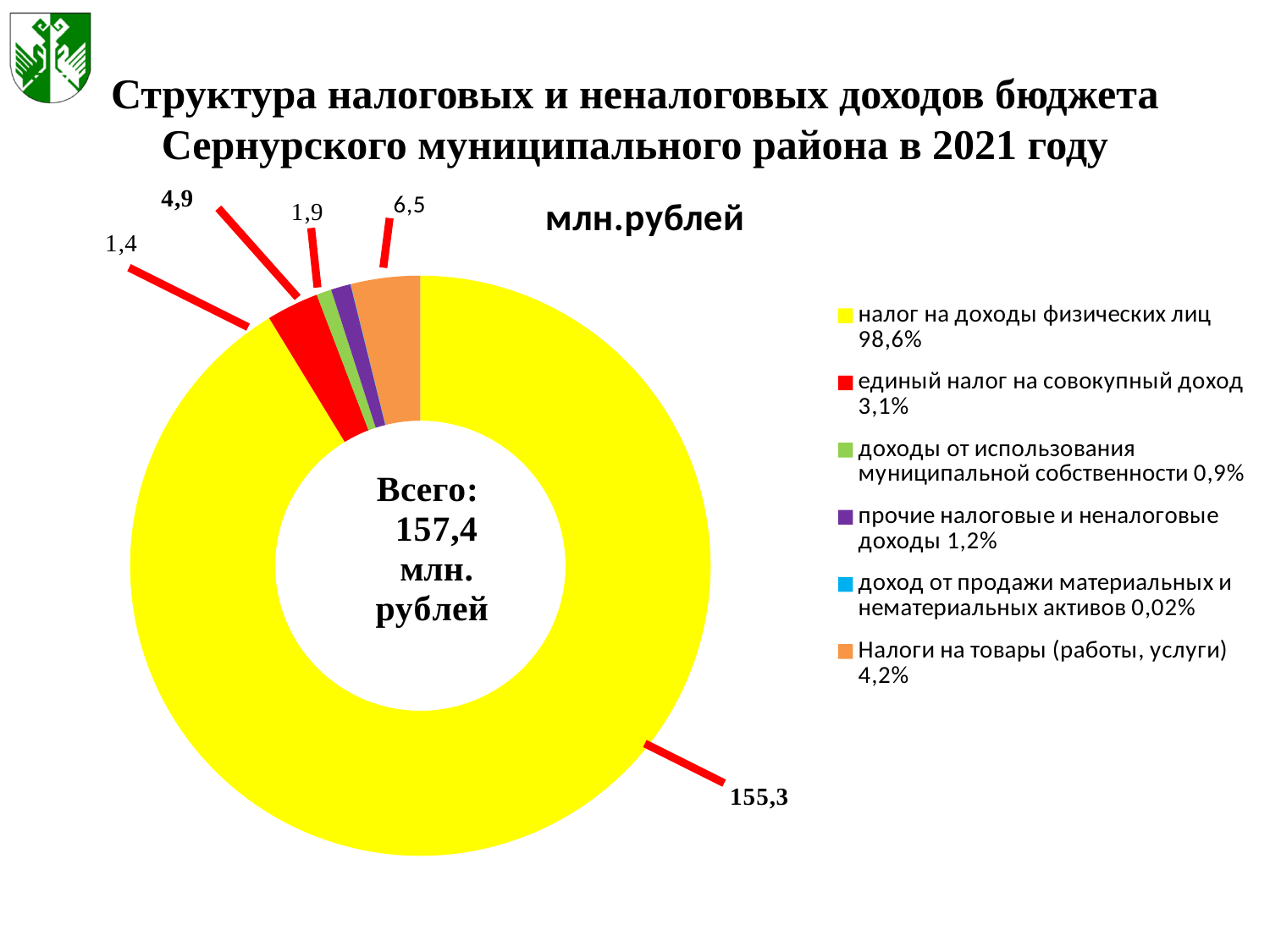
What kind of chart is shown on the slide? Doughnut (pie) chart What share of the chart does Налоги на товары (работы, услуги) represent? 4,2% What is the value for налог на доходы физических лиц? 155,3 How many categories does the legend list? 6 What is the value for прочие налоговые и неналоговые доходы? 1,9 What is the value for единый налог на совокупный доход? 4,9 What total amount is shown in the centre of the chart? 157,4 млн. рублей Which category has the smallest share according to the legend? доход от продажи материальных и нематериальных активов Which is larger: Налоги на товары (работы, услуги) or прочие налоговые и неналоговые доходы? Налоги на товары (работы, услуги) Which category has the largest share of the chart? налог на доходы физических лиц What is the value for Налоги на товары (работы, услуги)? 6,5 What share of the chart does единый налог на совокупный доход represent? 3,1%